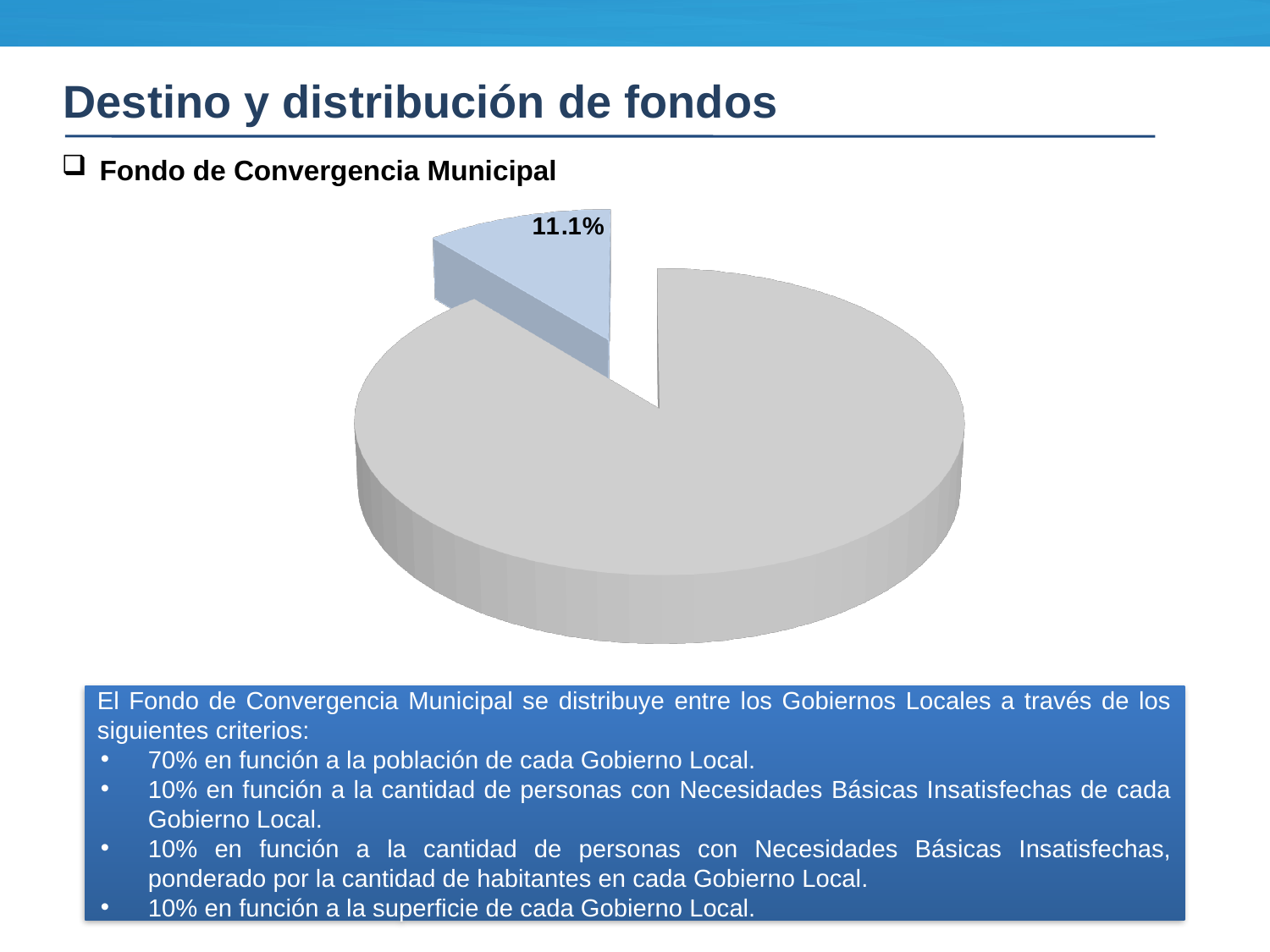
What colour is the slice that is pulled out from the pie chart? light blue What share of the pie does the light blue slice represent? 11.1% What kind of chart is shown on the slide? pie chart How many slices does the pie chart have? 2 What percentage is printed on the small exploded slice of the pie chart? 11.1% Is the value of the light blue slice greater or less than 50%? less Which slice of the pie chart is larger, the grey slice or the light blue slice? the grey slice How many slices of the pie chart have a data label printed? 1 Which slice of the pie chart is the smallest? the light blue slice (11.1%)